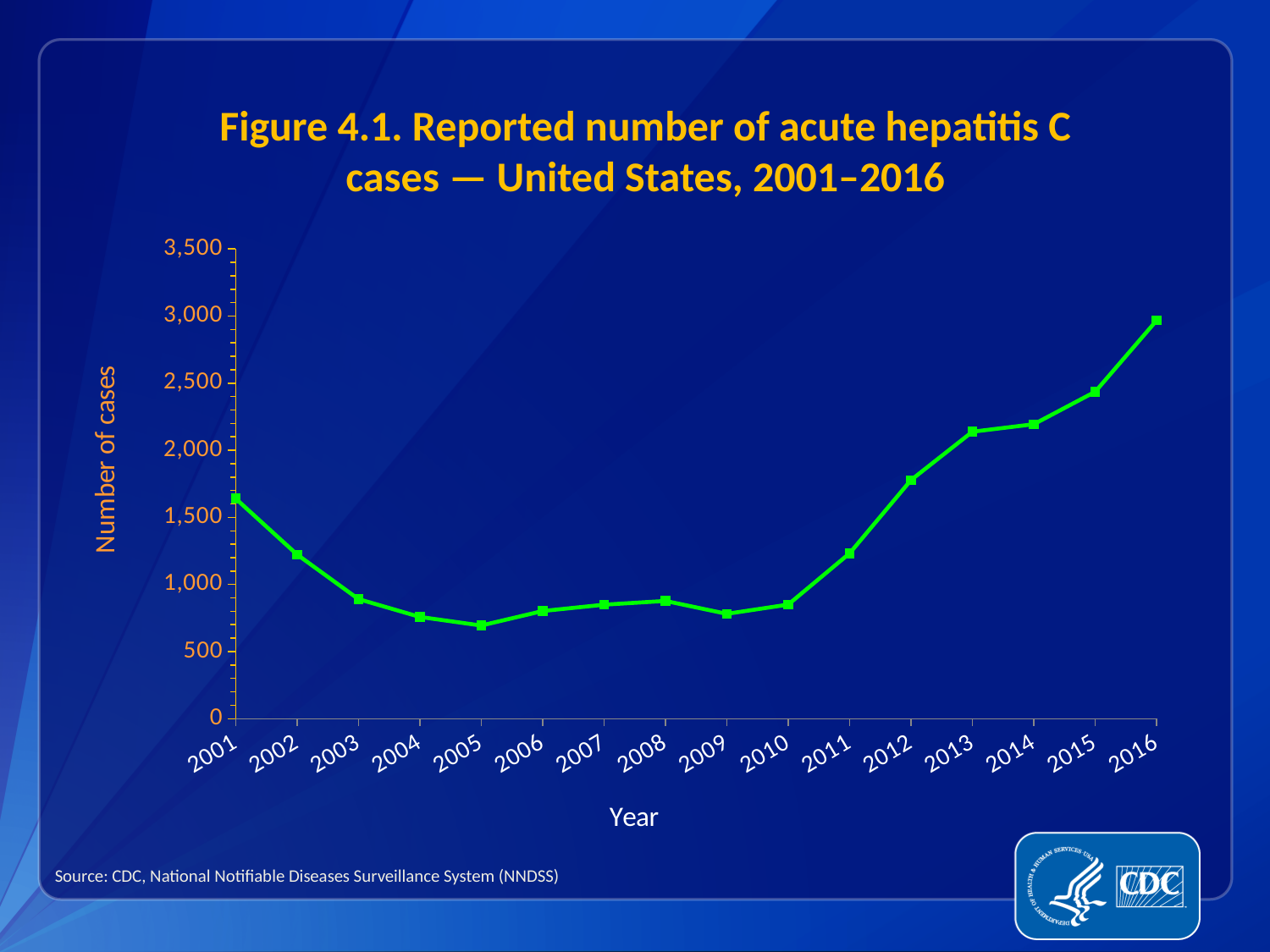
Which year has the highest reported number of acute hepatitis C cases? 2016 Is the value for 2016 greater or less than 2,500? greater Which year has the lowest reported number of acute hepatitis C cases? 2005 Which year has more reported cases, 2011 or 2012? 2012 What kind of chart is shown on the slide? Line chart What is the label of the vertical axis? Number of cases Is the value for 2001 greater or less than 1,500? greater Which year has more reported cases, 2001 or 2002? 2001 Is the value for 2005 greater or less than 1,000? less Do the reported cases rise or fall from 2010 to 2016? Rise How many years (data points) are plotted on the chart? 16